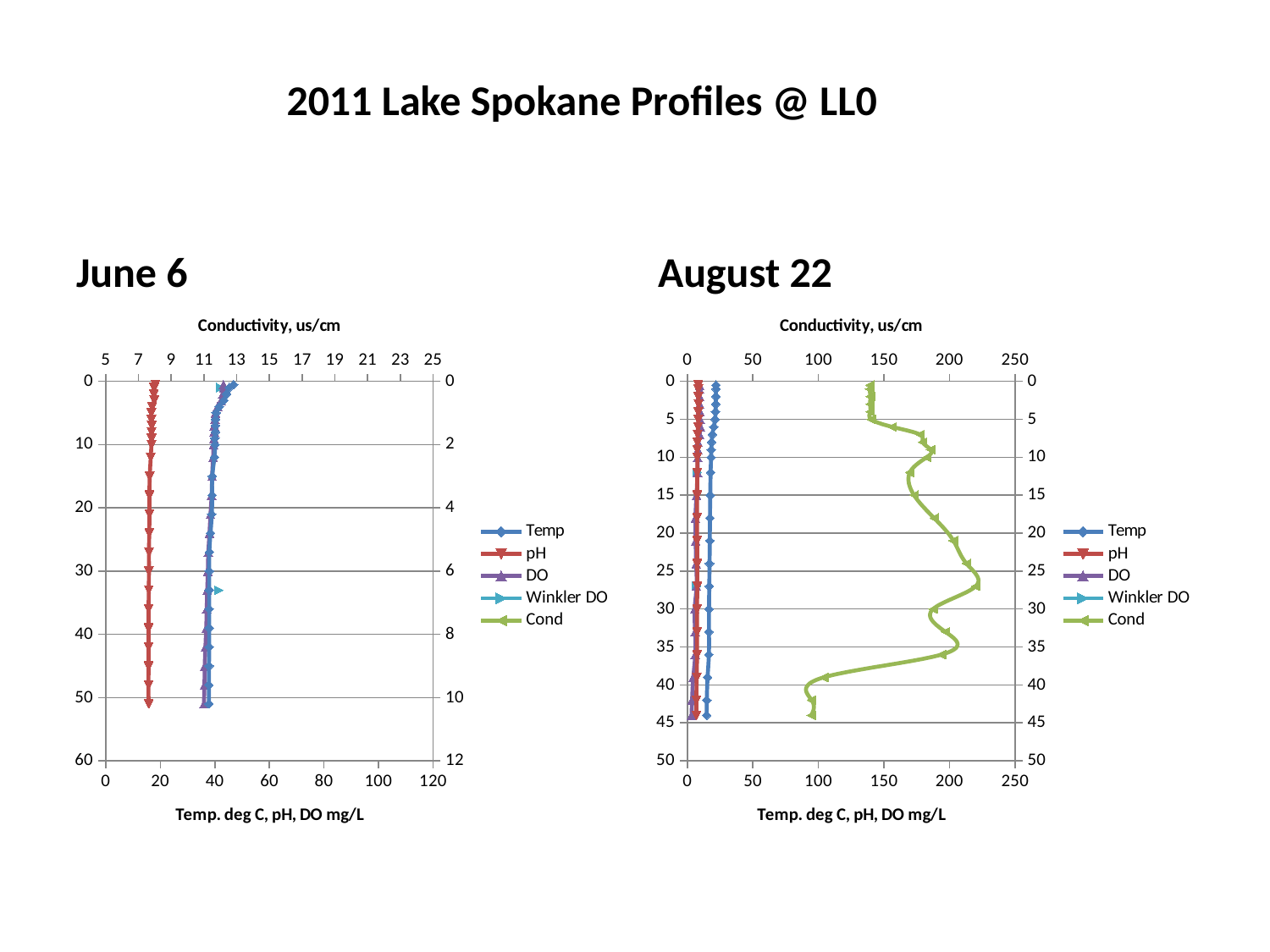
How many series does the legend of the August 22 chart list? 5 How many series does the legend of the June 6 chart list? 5 On the August 22 chart, does the Cond series increase or decrease between depth 0 and depth 25? increase On the August 22 chart, is the Cond value at depth 0 greater or less than 100 on the top axis? greater What is the title of the top horizontal axis on the August 22 chart? Conductivity, us/cm What kind of chart is the August 22 chart? line chart On the August 22 chart, does the Cond series increase or decrease between depth 35 and depth 40? decrease On the August 22 chart, is the Cond value at depth 40 greater or less than 150 on the top axis? less On the August 22 chart, is the Temp value at depth 0 greater or less than 50 on the bottom axis? less What is the title of the bottom horizontal axis on the June 6 chart? Temp. deg C, pH, DO mg/L What is the maximum value shown on the top (Conductivity) axis of the August 22 chart? 250